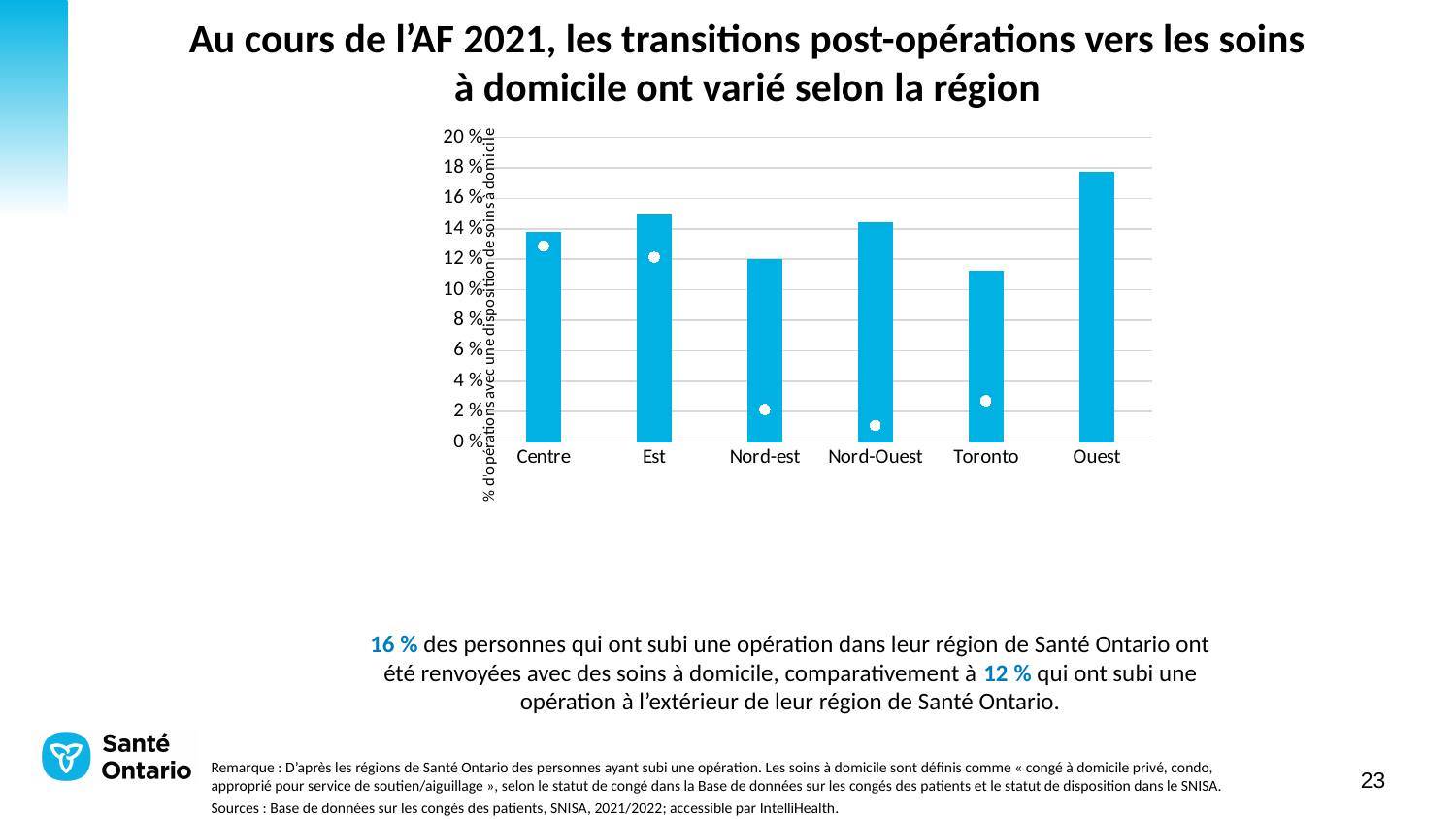
Which bar is taller, Est or Nord-est? Est Which bar is taller, Toronto or Ouest? Ouest Is the bar for Nord-est greater or less than 14 %? less What is the highest value shown on the y axis of the chart? 20 % Is the bar for Centre greater or less than 12 %? greater How many regions are shown on the x axis of the chart? 6 Is the bar for Ouest greater or less than 16 %? greater Which region has the lowest bar in the chart? Toronto Which region has the highest bar in the chart? Ouest What kind of chart is shown on the slide? bar chart